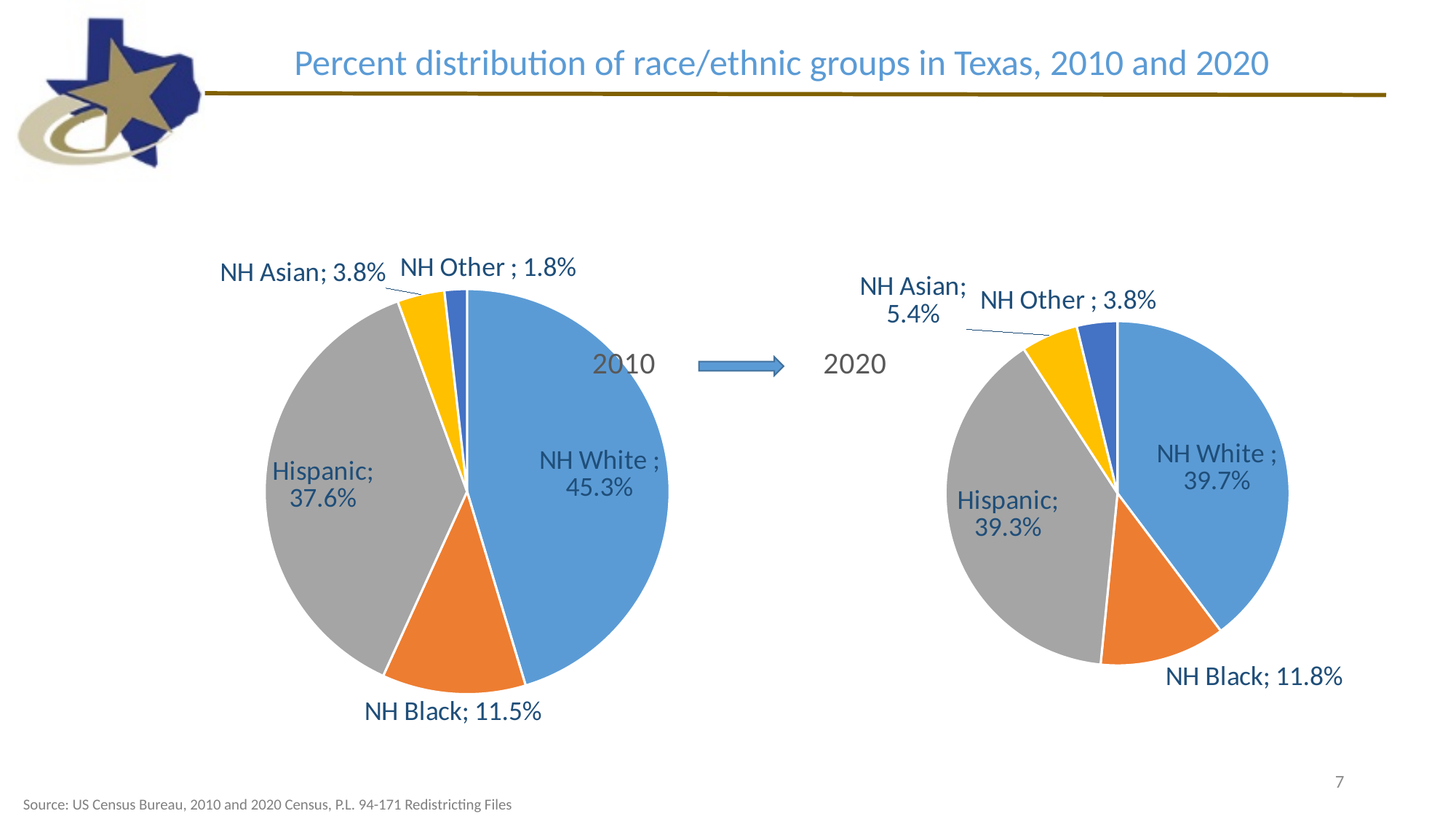
In the 2020 pie chart, which is larger: the NH Black share or the NH Asian share? NH Black What kind of chart is used on this slide? Pie chart How many groups are shown in the 2020 pie chart? 5 In the 2010 pie chart, what is the difference between the NH White share and the Hispanic share? 7.7% In the 2010 pie chart, what is the share for NH Other? 1.8% In the 2020 pie chart, what is the share for Hispanic? 39.3% In the 2020 pie chart, which group has the smallest share? NH Other In the 2010 pie chart, what is the share for NH White? 45.3% In the 2020 pie chart, what is the share for NH Asian? 5.4% What colour is the Hispanic slice in both pie charts? Gray In the 2010 pie chart, which group has the largest share? NH White What is the difference between the NH Black share in 2020 and in 2010? 0.3%